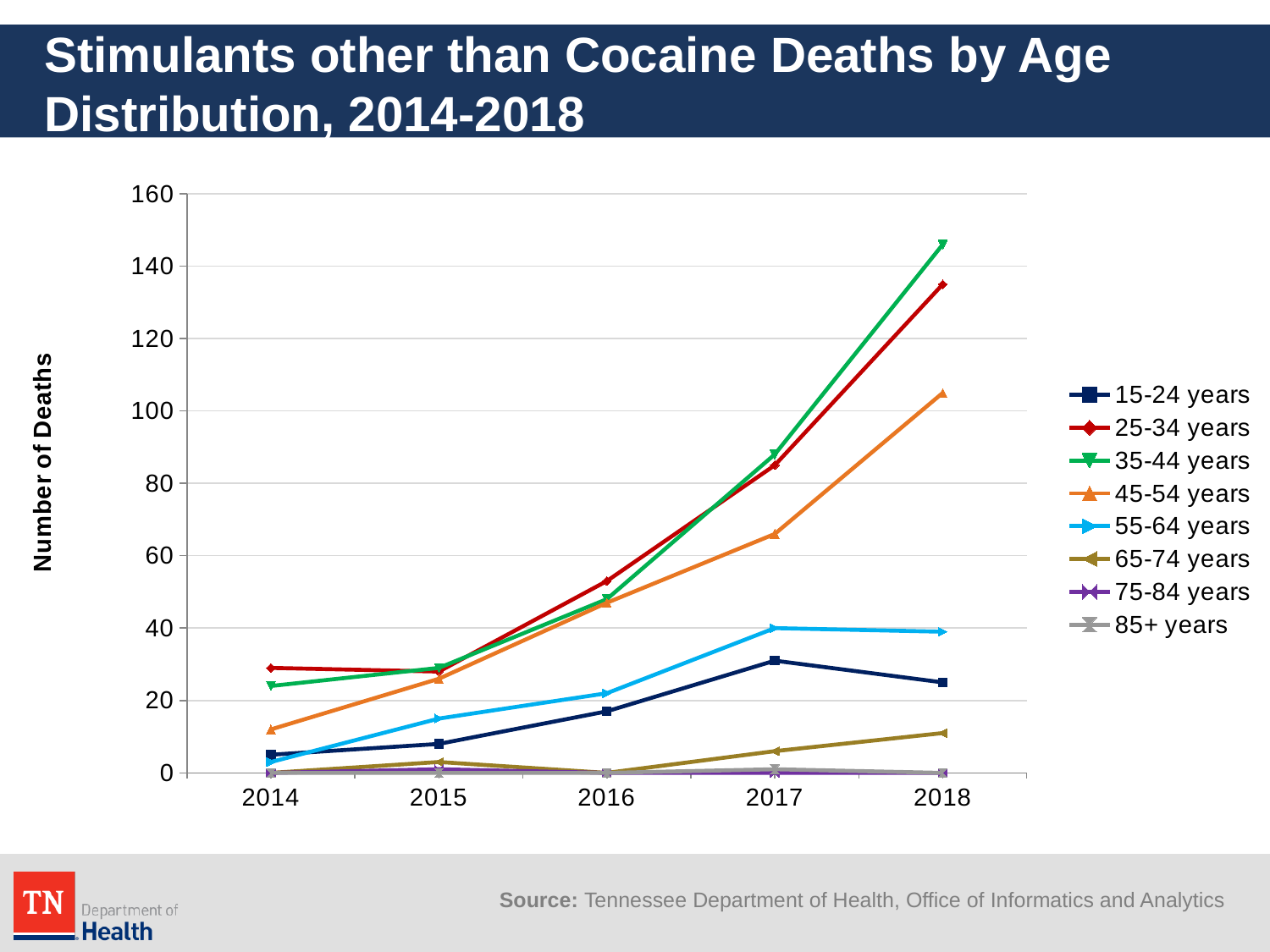
What is the title of the y axis? Number of Deaths How many years are shown along the x axis? 5 In 2018, which is larger: the value for 25-34 years or the value for 45-54 years? 25-34 years Is the value for 25-34 years in 2014 greater or less than 40? less Do the values for 45-54 years rise or fall from 2014 to 2018? rise Is the value for 15-24 years in 2017 greater or less than 40? less Is the value for 25-34 years in 2018 greater or less than 120? greater What kind of chart is shown on the slide? line chart How many series does the legend list? 8 Which age group has the highest number of deaths in 2018? 35-44 years